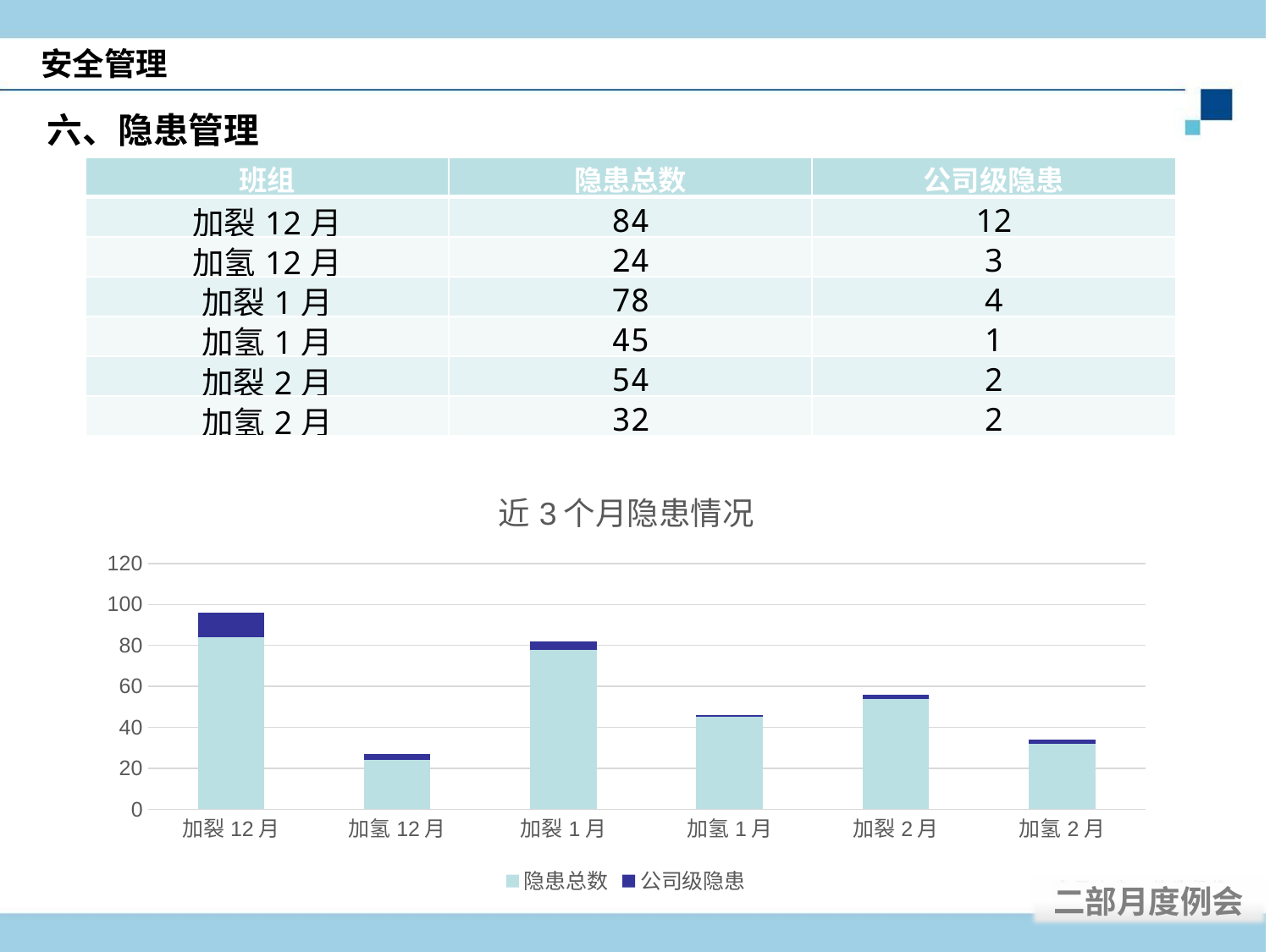
What is the 公司级隐患 value for 加氢 1 月? 1 Which category has the highest 隐患总数? 加裂 12 月 Which category has the lowest 隐患总数? 加氢 12 月 What is the total height of the stacked bar for 加裂 12 月 (隐患总数 plus 公司级隐患)? 96 What is the difference in 隐患总数 between 加裂 1 月 and 加氢 1 月? 33 How many categories are shown on the x axis of the chart? 6 What type of chart is shown under the title 近3个月隐患情况? stacked bar chart What is the 隐患总数 value for 加裂 12 月? 84 Which has a larger 隐患总数, 加裂 2 月 or 加氢 2 月? 加裂 2 月 Is the stacked bar for 加氢 1 月 greater or less than 60? less What is the title of the chart? 近3个月隐患情况 How many series does the legend of the chart list? 2